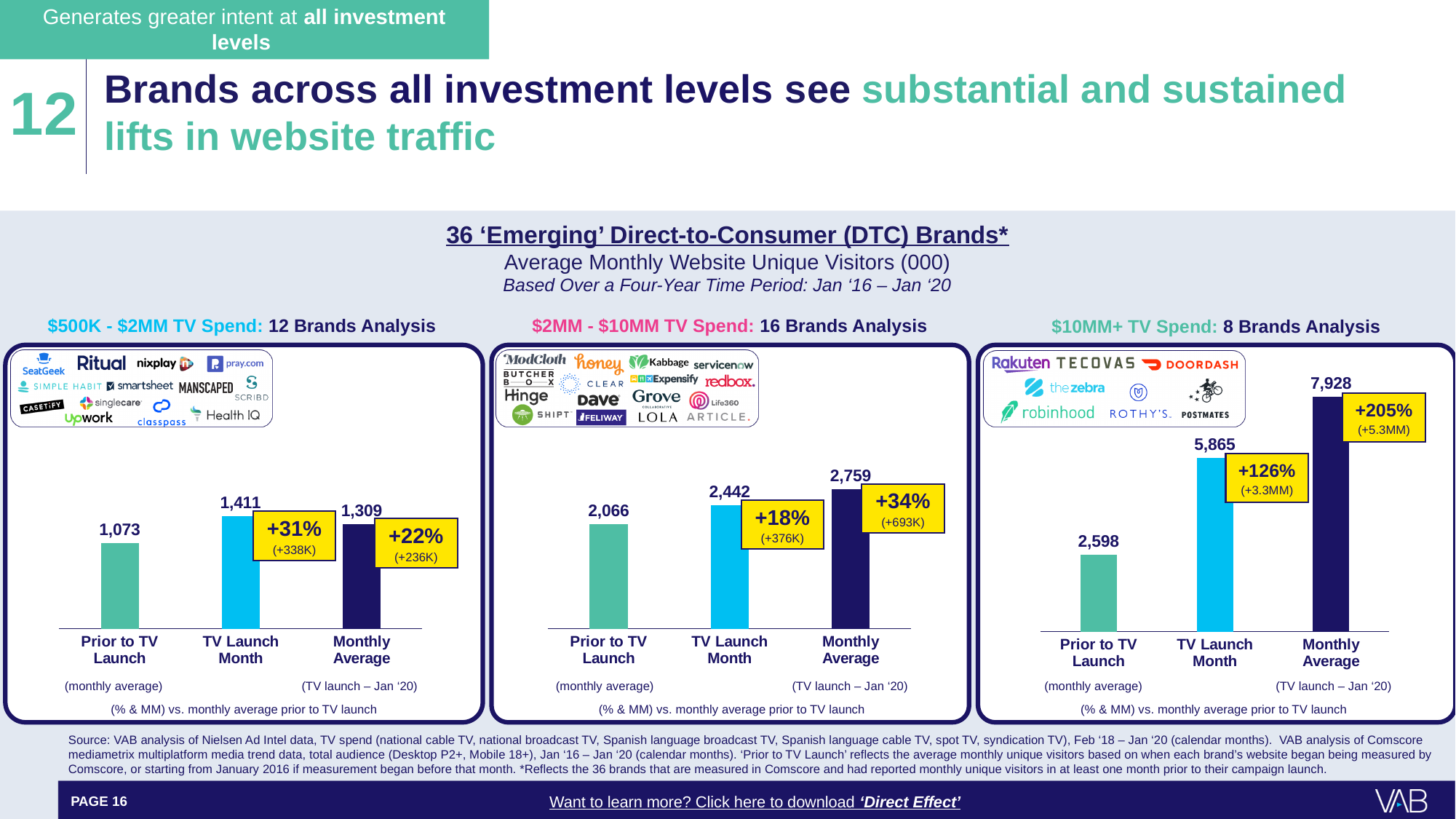
What percentage lift is labelled on the Monthly Average bar in the $10MM+ TV Spend chart? +205% In the $500K - $2MM TV Spend chart, what is the value for Prior to TV Launch? 1,073 In the $2MM - $10MM TV Spend chart, do the values rise or fall from left to right? rise In the $10MM+ TV Spend chart, what is the value for TV Launch Month? 5,865 What kind of chart is the $2MM - $10MM TV Spend chart? bar chart In the $10MM+ TV Spend chart, which is larger, Monthly Average or TV Launch Month? Monthly Average In the $500K - $2MM TV Spend chart, which category has the highest value? TV Launch Month In the $500K - $2MM TV Spend chart, what is the difference between TV Launch Month and Prior to TV Launch? 338 In the $10MM+ TV Spend chart, what is the difference between Monthly Average and Prior to TV Launch? 5,330 In the $2MM - $10MM TV Spend chart, what is the value for Monthly Average? 2,759 How many categories are shown in the $10MM+ TV Spend chart? 3 In the $2MM - $10MM TV Spend chart, which category has the lowest value? Prior to TV Launch